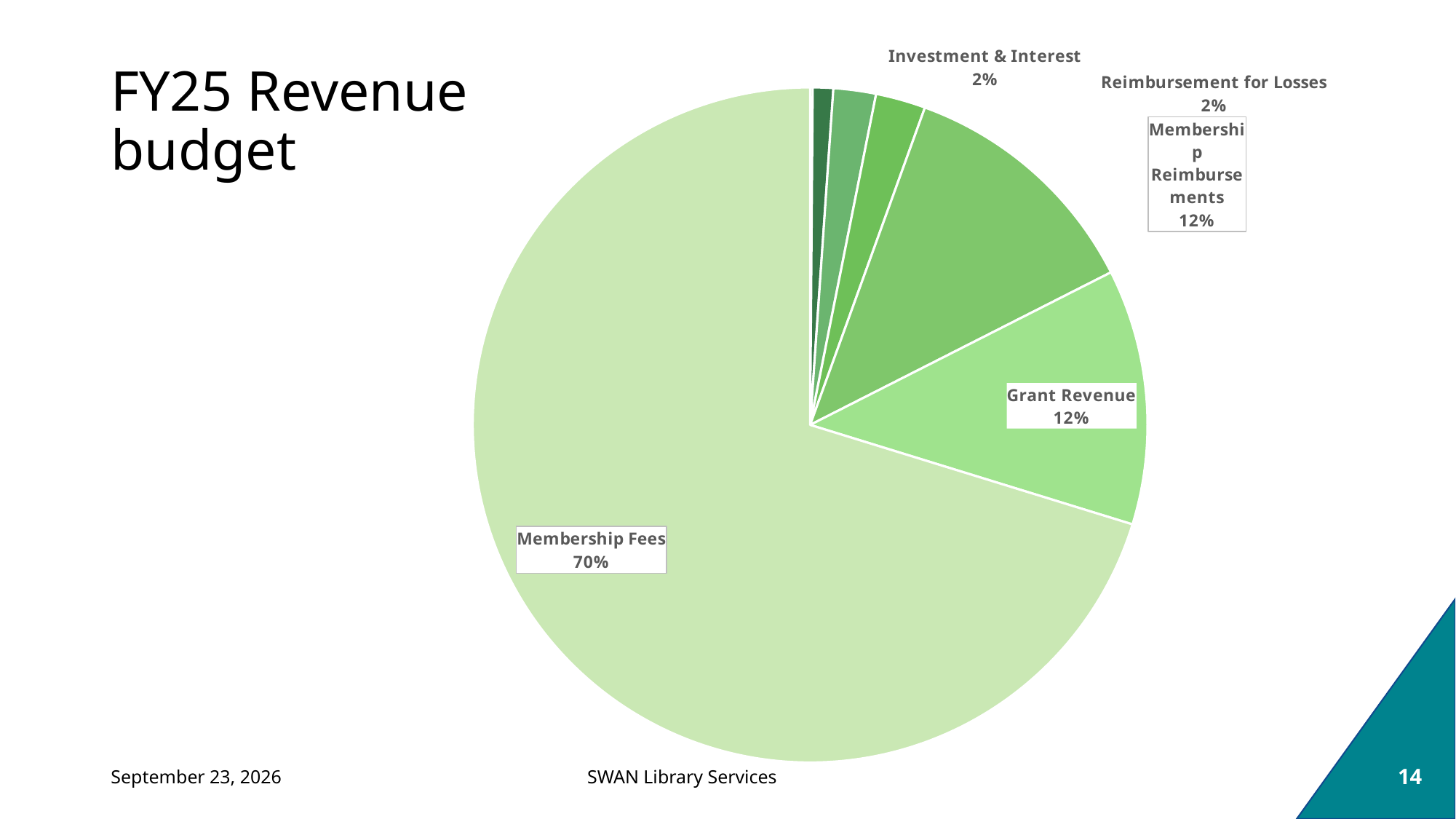
What is the title of the slide containing the pie chart? FY25 Revenue budget What percentage is shown for Investment & Interest? 2% How many percentage points larger is the Membership Reimbursements share than the Reimbursement for Losses share? 10 percentage points What percentage is shown for Membership Reimbursements? 12% What percentage is shown for Reimbursement for Losses? 2% What percentage of the pie is Grant Revenue? 12% What share of the FY25 revenue budget comes from Membership Fees? 70% How many percentage points larger is the Membership Fees share than the Grant Revenue share? 58 percentage points What kind of chart is shown on the slide? Pie chart Which is larger, the share for Grant Revenue or the share for Investment & Interest? Grant Revenue Which is larger, the share for Membership Fees or the share for Grant Revenue? Membership Fees Which category makes up the largest share of the pie? Membership Fees